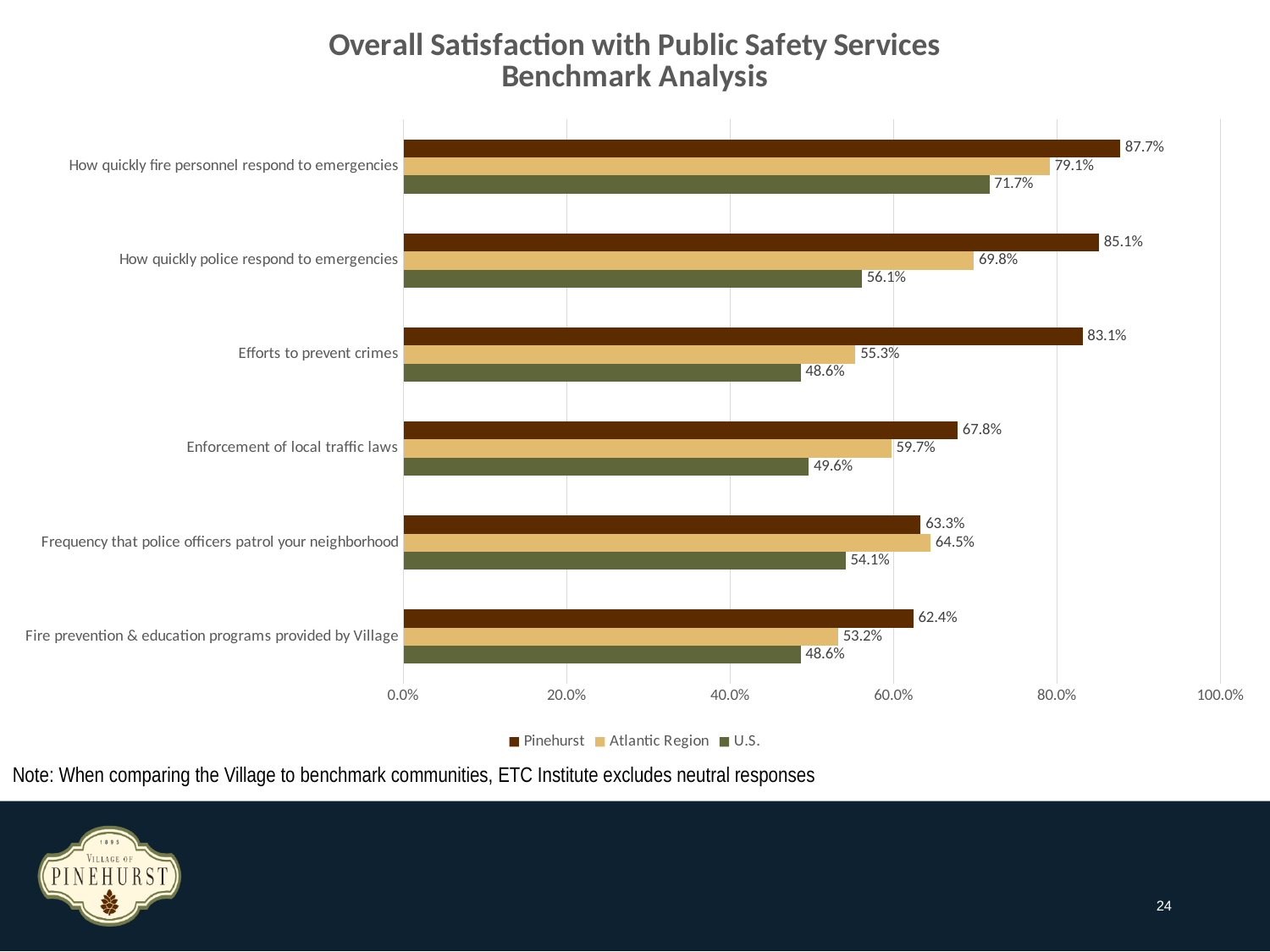
Which category has the lowest Pinehurst value? Fire prevention & education programs provided by Village What is the difference between the Pinehurst and U.S. values for 'Efforts to prevent crimes'? 34.5% Is the U.S. value for 'Enforcement of local traffic laws' greater or less than 60.0%? less What is the Pinehurst value for 'How quickly fire personnel respond to emergencies'? 87.7% What is the Atlantic Region value for 'Efforts to prevent crimes'? 55.3% Which category has the highest Pinehurst value? How quickly fire personnel respond to emergencies What is the U.S. value for 'How quickly police respond to emergencies'? 56.1% How many categories are shown on the chart? 6 How many series does the legend list? 3 What is the difference between the Pinehurst and Atlantic Region values for 'How quickly police respond to emergencies'? 15.3% What kind of chart is shown on the slide? bar chart For 'Frequency that police officers patrol your neighborhood', which is larger: the Pinehurst value or the Atlantic Region value? Atlantic Region